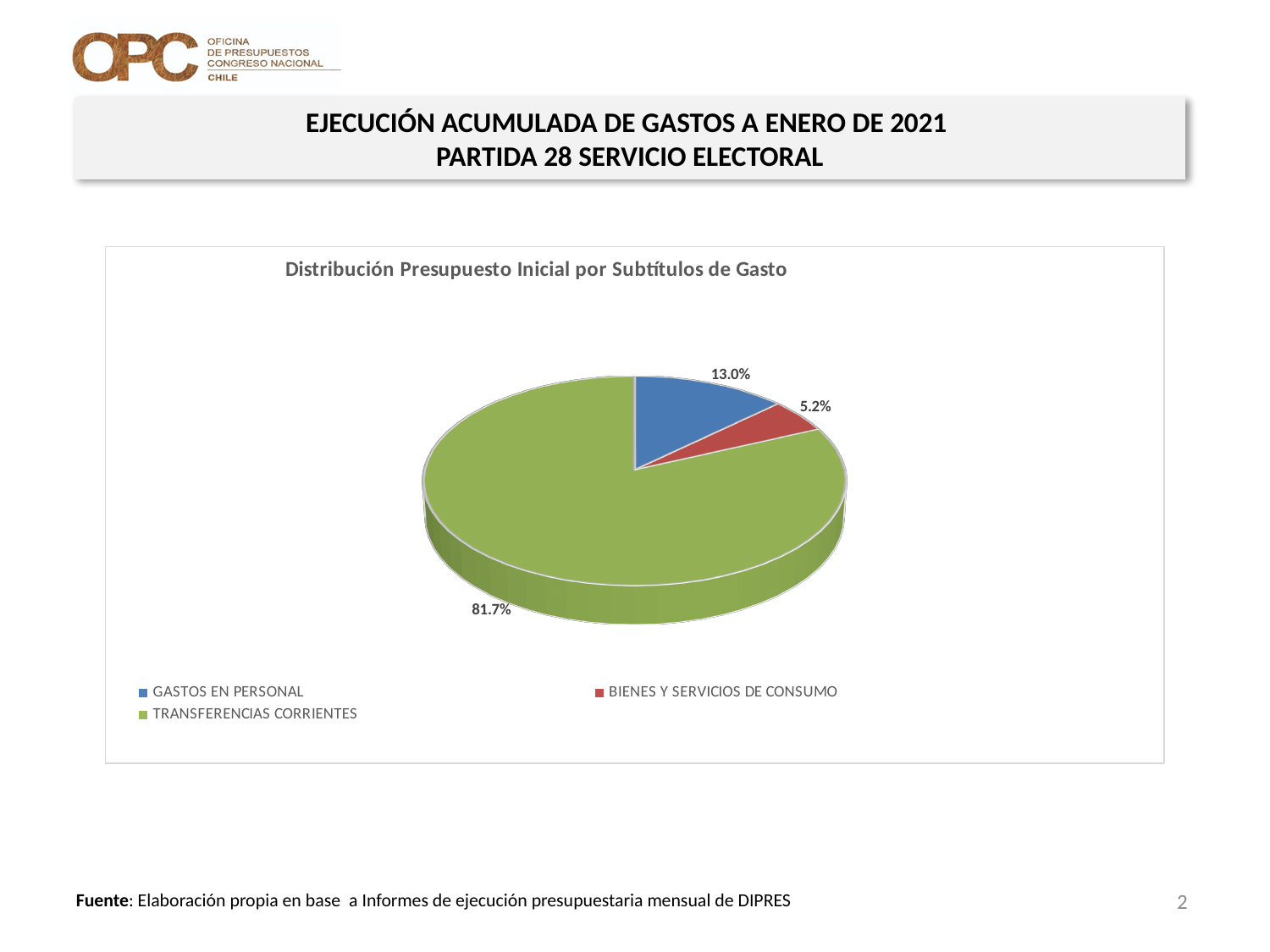
What share of the pie does TRANSFERENCIAS CORRIENTES represent? 81.7% What share of the pie does BIENES Y SERVICIOS DE CONSUMO represent? 5.2% What share of the pie does GASTOS EN PERSONAL represent? 13.0% What is the difference in percentage points between GASTOS EN PERSONAL and BIENES Y SERVICIOS DE CONSUMO? 7.8 percentage points What is the difference in percentage points between TRANSFERENCIAS CORRIENTES and GASTOS EN PERSONAL? 68.7 percentage points What type of chart is shown on the slide? Pie chart What is the title of the chart? Distribución Presupuesto Inicial por Subtítulos de Gasto Which category has the largest slice of the pie? TRANSFERENCIAS CORRIENTES What colour is the slice for TRANSFERENCIAS CORRIENTES? Green How many categories does the pie chart show? 3 Which is larger, the share for GASTOS EN PERSONAL or the share for BIENES Y SERVICIOS DE CONSUMO? GASTOS EN PERSONAL Which category has the smallest slice of the pie? BIENES Y SERVICIOS DE CONSUMO